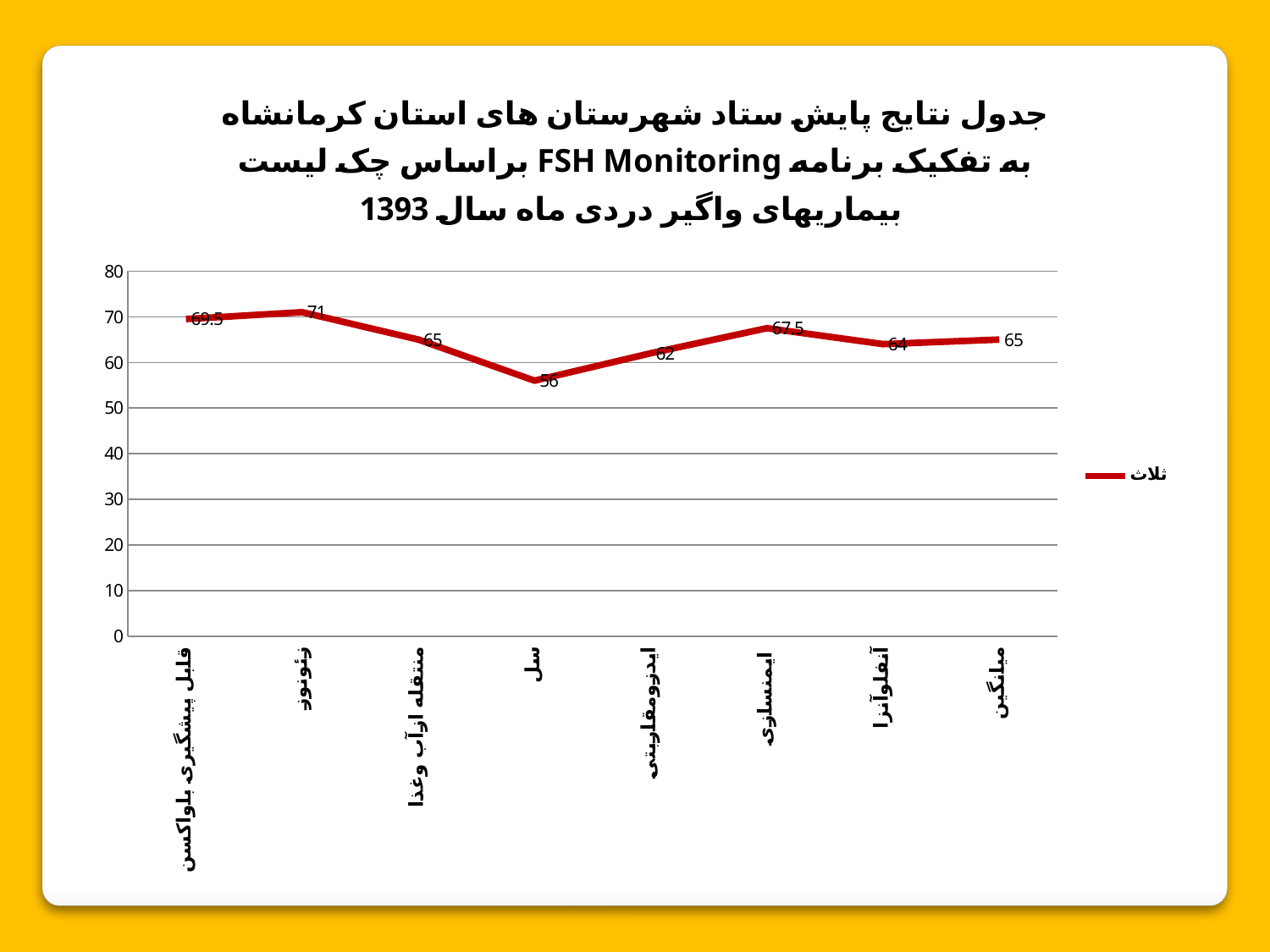
What is the name of the series shown in the legend? ثلاث What type of chart is shown on the slide? line chart How many series does the legend list? 1 What is the difference between the values for زئونوز and سل? 15 Which category has the lowest value? سل Which category has the highest value? زئونوز What is the value for آنفلوآنزا? 64 What is the value for زئونوز? 71 How many categories are plotted on the x axis? 8 What is the value for سل? 56 Which is larger, the value for ایمنسازی or the value for ایدز و مقاربتی? ایمنسازی What is the value for ایمنسازی? 67.5